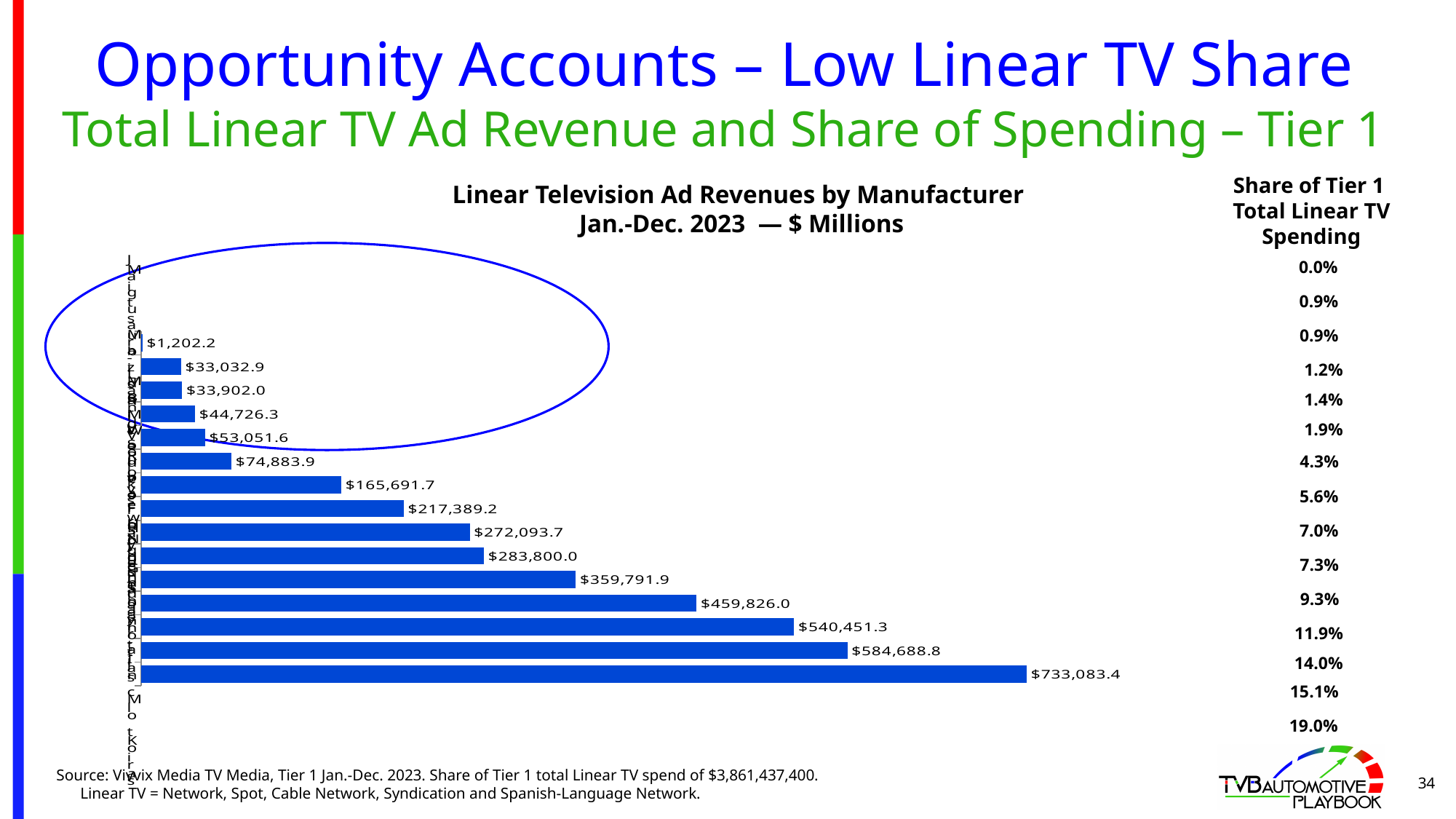
What is the difference between the bars labeled $33,902.0 and $33,032.9? $869.1 What colour are the bars in the chart? Blue How many bars have data labels in the chart? 15 Which is larger, the bar labeled $459,826.0 or the bar labeled $359,791.9? $459,826.0 What is the smallest value labeled on any bar in the chart? $1,202.2 Do the bar values increase or decrease going from the top of the chart to the bottom? Increase What is the highest value listed in the 'Share of Tier 1 Total Linear TV Spending' column? 19.0% What is the largest value labeled on any bar in the chart? $733,083.4 What kind of chart is shown on the slide? Bar chart What is the lowest value listed in the 'Share of Tier 1 Total Linear TV Spending' column? 0.0% What is the title of the chart? Linear Television Ad Revenues by Manufacturer Jan.-Dec. 2023 — $ Millions What is the difference between the largest bar ($733,083.4) and the second-largest bar ($584,688.8)? $148,394.6